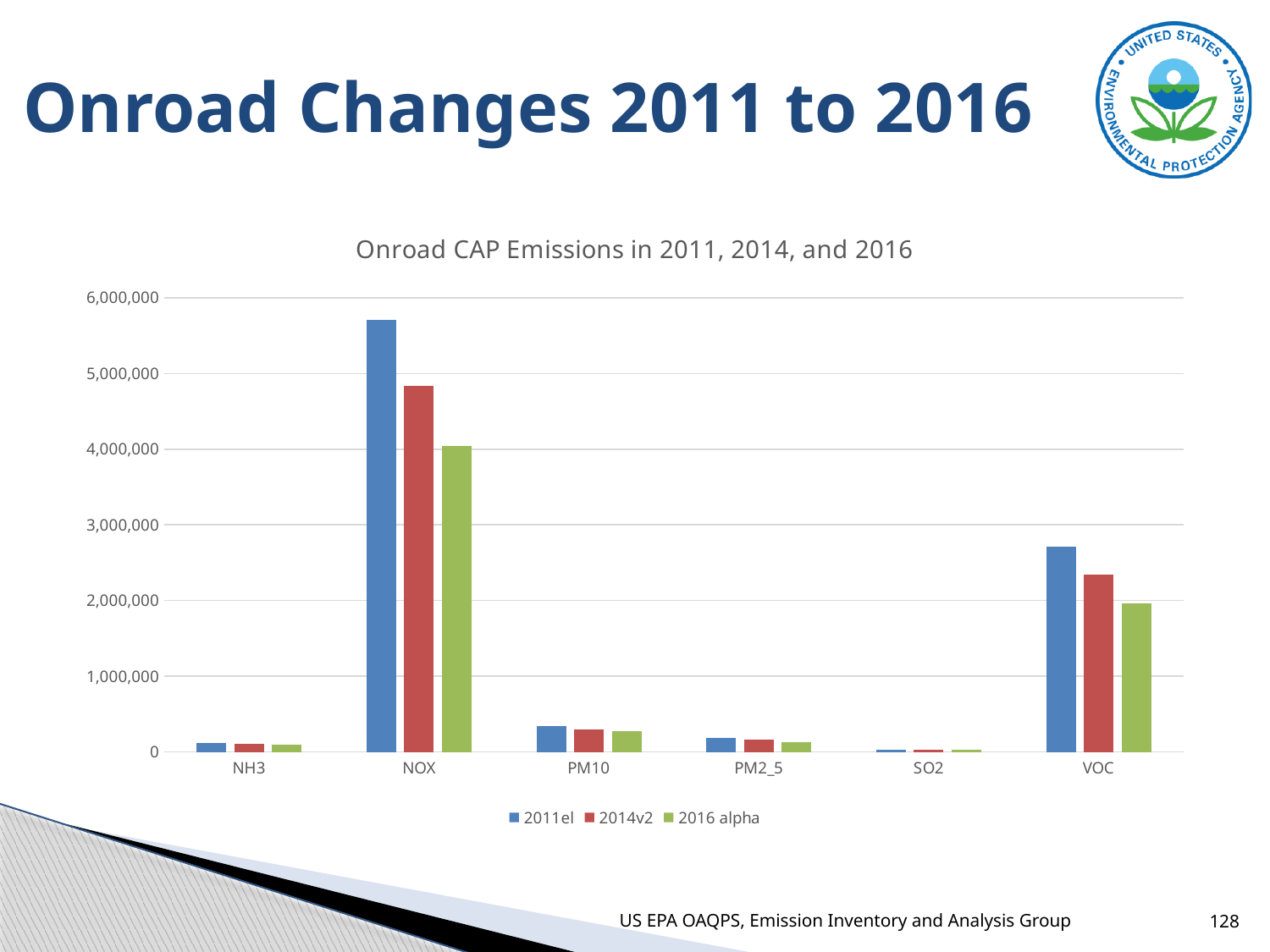
Which is larger for 2016 alpha: NOX or VOC? NOX Is the 2011el value for NOX greater or less than 5,000,000? greater How many series does the legend list? 3 Is the 2011el value for VOC greater or less than 3,000,000? less Is the 2014v2 value for NOX greater or less than 5,000,000? less Which pollutant has the lowest 2011el emissions? SO2 What kind of chart is shown on the slide? bar chart Which pollutant has the highest 2011el emissions? NOX For NOX, do the values rise or fall from 2011el to 2014v2 to 2016 alpha? fall How many pollutant categories are shown on the x axis? 6 What is the title of the chart? Onroad CAP Emissions in 2011, 2014, and 2016